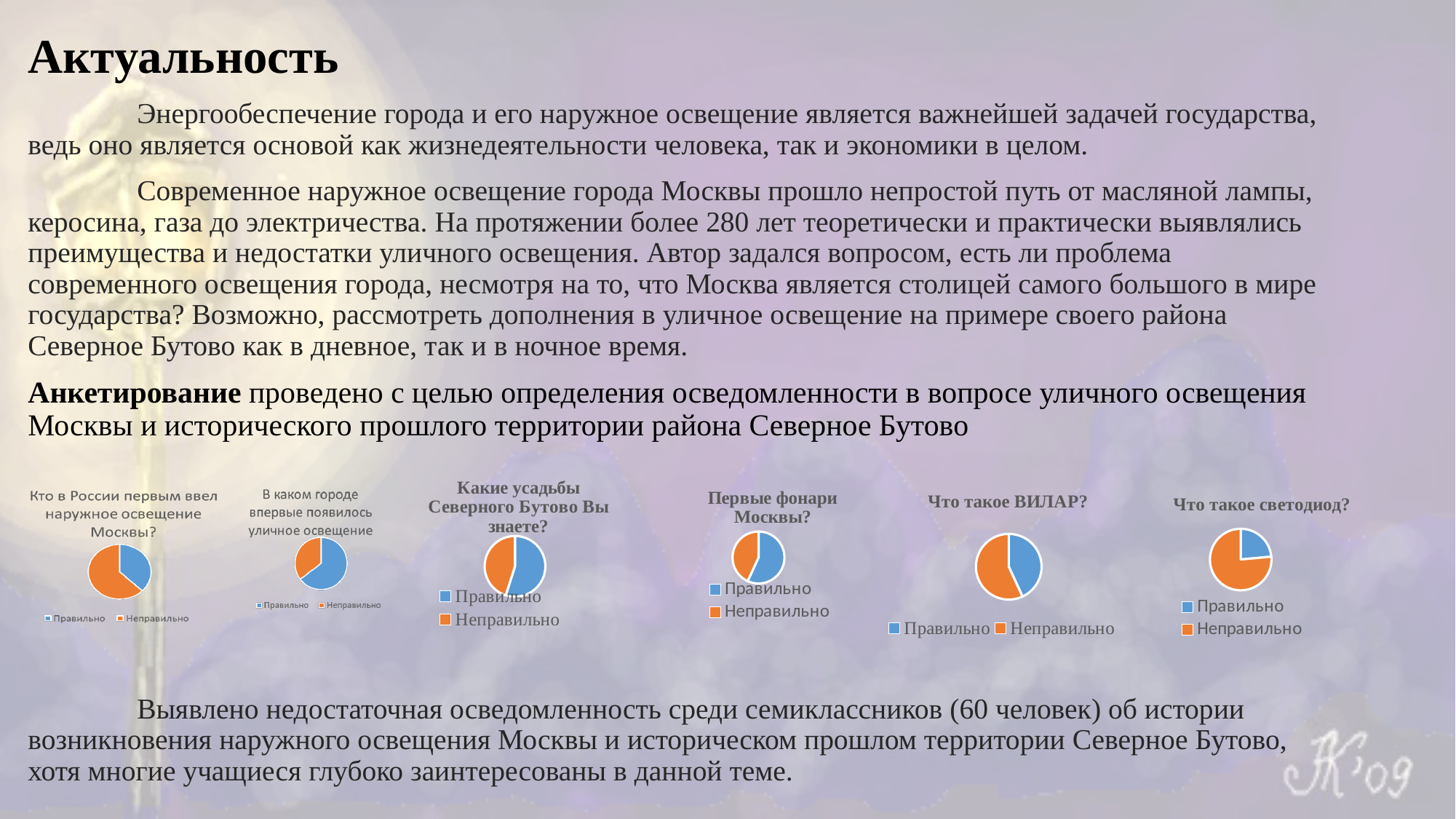
In the chart "Кто в России первым ввел наружное освещение Москвы?", which slice is larger, Правильно or Неправильно? Неправильно How many pie charts are shown on the slide? 6 What kind of chart is used for the question "Кто в России первым ввел наружное освещение Москвы?"? pie chart In the chart "В каком городе впервые появилось уличное освещение", which slice is the largest? Правильно In the chart "Что такое светодиод?", which slice is larger, Правильно or Неправильно? Неправильно In the chart "В каком городе впервые появилось уличное освещение", which slice is larger, Правильно or Неправильно? Правильно In the chart "Что такое светодиод?", which slice is the smallest? Правильно How many slices does the pie chart "Первые фонари Москвы?" have? 2 What colour represents Неправильно in the pie charts? orange In the chart "Что такое светодиод?", how many entries does the legend list? 2 What is the title of the rightmost pie chart on the slide? Что такое светодиод?